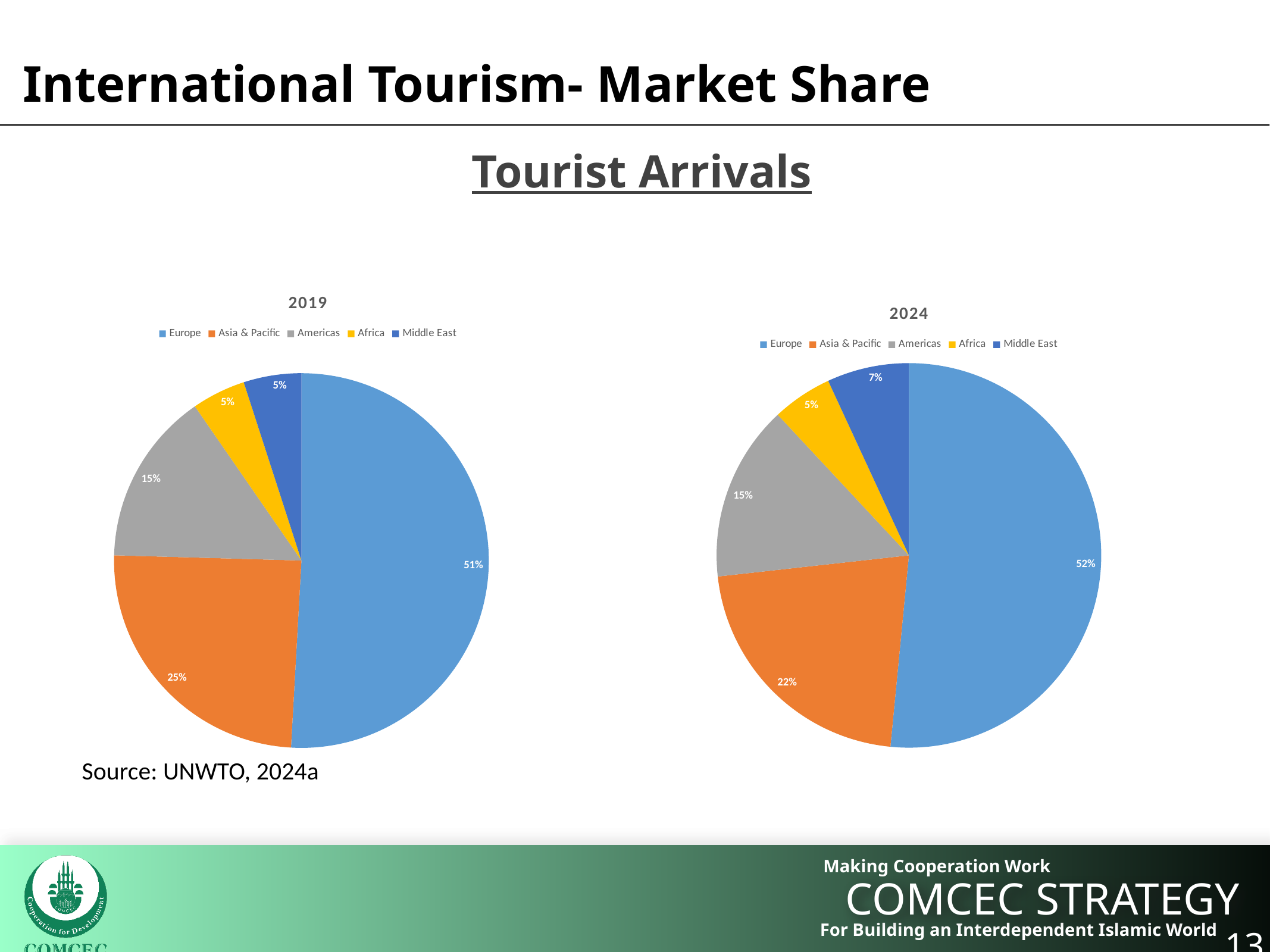
In the 2019 pie chart, which is larger: the Asia & Pacific share or the Americas share? Asia & Pacific In the 2024 pie chart, which region has the smallest share? Africa In the 2024 pie chart, what share of tourist arrivals does Asia & Pacific have? 22% In the 2019 pie chart, what share of tourist arrivals does Europe have? 51% How many entries does the legend of the 2019 chart list? 5 In the 2019 pie chart, what share does Americas have? 15% In the 2019 pie chart, which region has the largest share? Europe In the 2024 pie chart, what share does the Middle East have? 7% In the 2024 pie chart, what is the difference between the Europe share and the Asia & Pacific share? 30% In the 2024 pie chart, which colour represents Africa? Yellow How many regions are shown in the 2024 pie chart? 5 What type of chart is used for the 2019 data? Pie chart